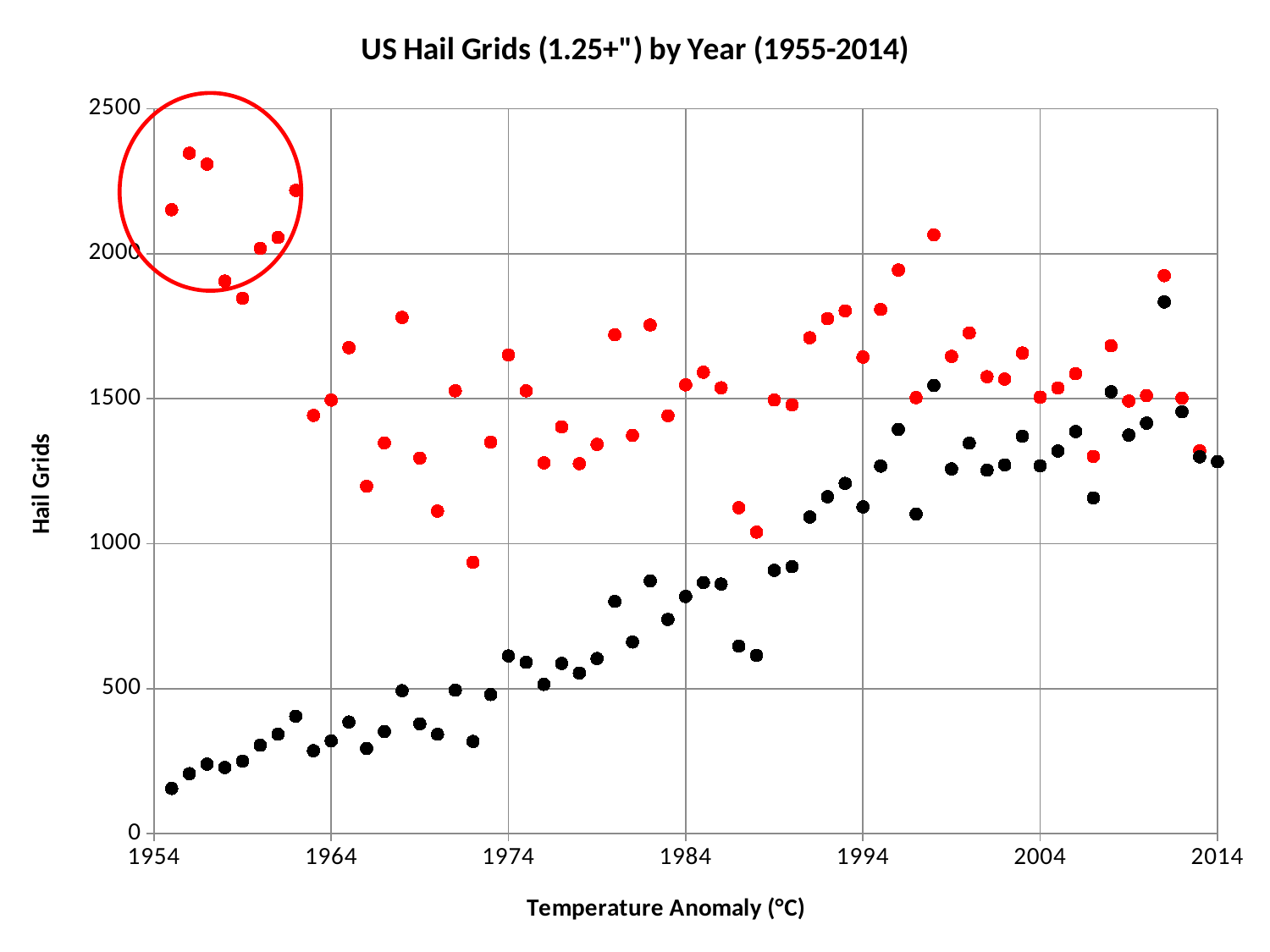
What is the label on the vertical axis of the chart? Hail Grids Is the value of the red point at 1955 greater or less than 2000? greater What is the title of the chart? US Hail Grids (1.25+") by Year (1955-2014) Is the value of the black point at 2011 greater or less than 1500? greater Is the value of the red point at 1973 greater or less than 1000? greater Do the black points generally rise or fall from 1955 to 2014? Rise Which year has the lowest black point on the chart? 1955 What kind of chart is shown on the slide? Scatter chart Which year has the highest black point on the chart? 2011 Which is larger at 1964, the red point or the black point? The red point